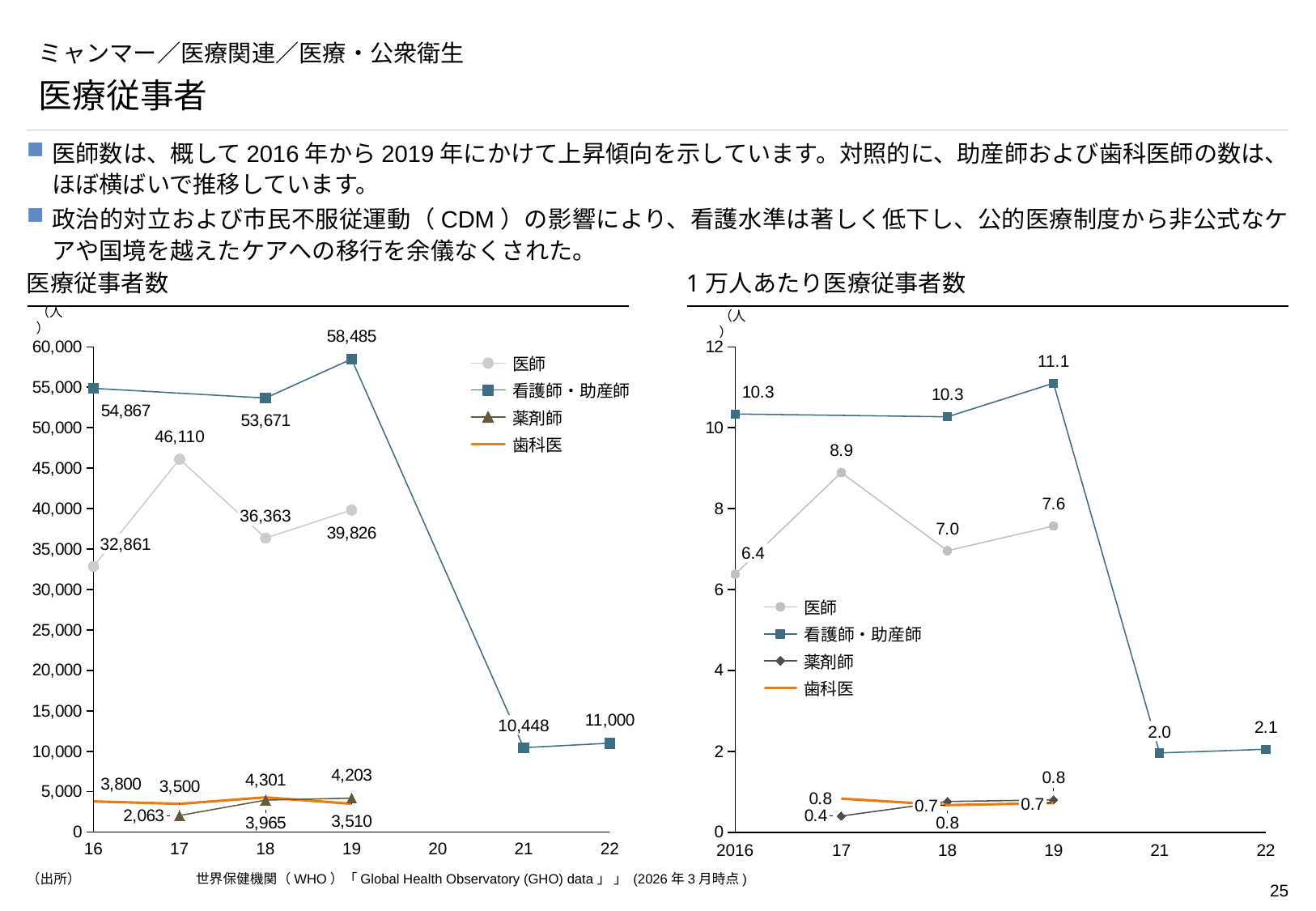
In the left chart (医療従事者数), what is the value for 医師 in 17? 46,110 How many series does the legend of the left chart (医療従事者数) list? 4 In the right chart (1万人あたり医療従事者数), what is the value for 医師 in 2016? 6.4 In the left chart (医療従事者数), what is the difference between the 看護師・助産師 values in 19 and 21? 48,037 In the right chart (1万人あたり医療従事者数), is the 医師 value larger in 18 or in 19? 19 In the left chart (医療従事者数), what is the value for 看護師・助産師 in 22? 11,000 In the right chart (1万人あたり医療従事者数), what is the value for 看護師・助産師 in 19? 11.1 In the left chart (医療従事者数), what is the value for 薬剤師 in 17? 2,063 In the right chart (1万人あたり医療従事者数), what is the difference between the 医師 values in 17 and 2016? 2.5 In the left chart (医療従事者数), what is the value for 看護師・助産師 in 19? 58,485 In the left chart (医療従事者数), in which year is the 医師 value highest? 17 What kind of chart is the right chart (1万人あたり医療従事者数)? Line chart